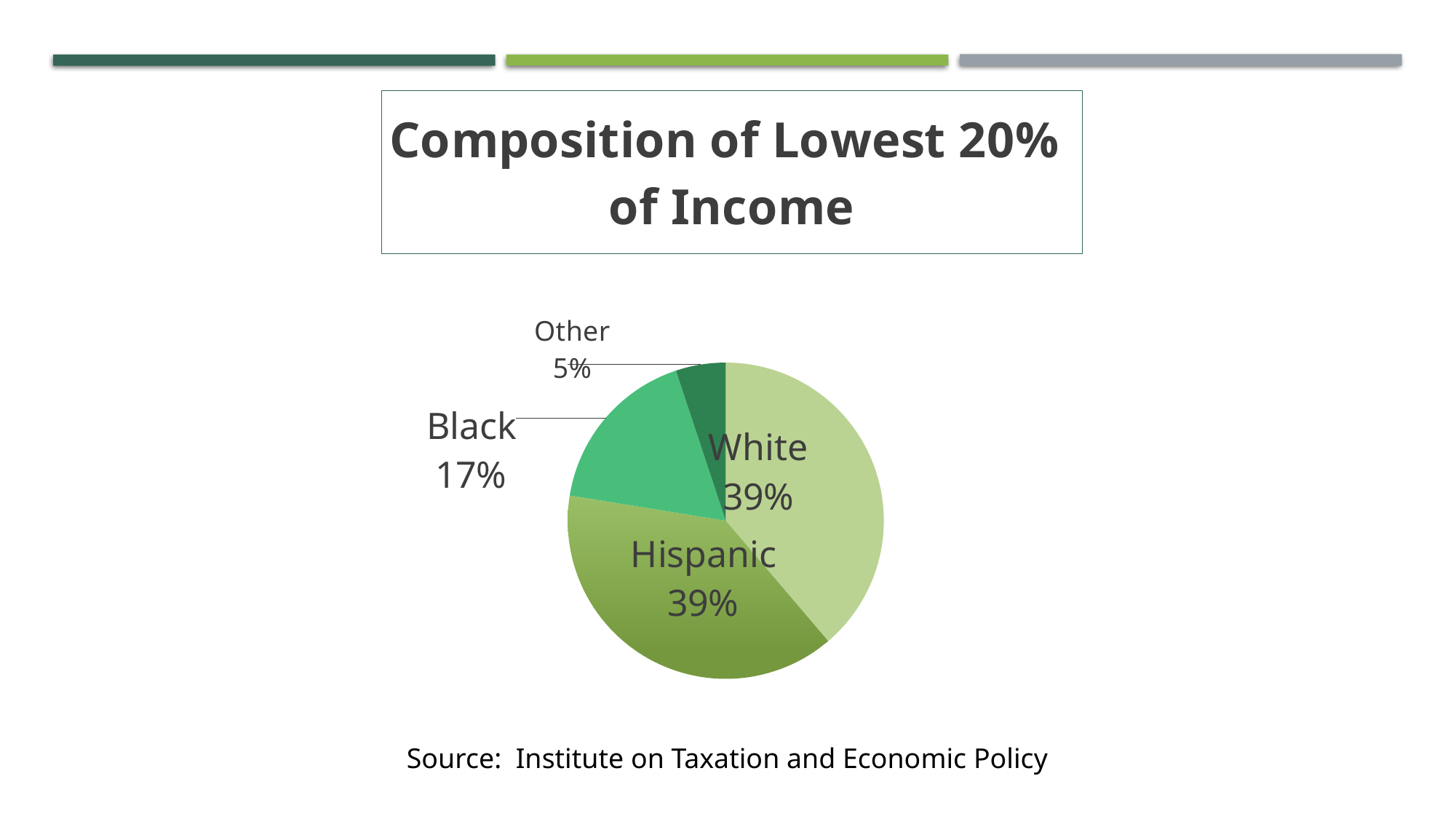
Which slice of the pie is the smallest? Other Which is larger, the Black slice or the Other slice? Black What is the difference in percentage points between the White slice and the Black slice? 22 How many slices does the pie chart have? 4 What kind of chart is shown on the slide? Pie chart What is the difference in percentage points between the Black slice and the Other slice? 12 What share of the pie does the Other slice represent? 5% What share of the pie does the Black slice represent? 17% What share of the pie does the Hispanic slice represent? 39% What is the title of the chart? Composition of Lowest 20% of Income What source is cited below the chart? Institute on Taxation and Economic Policy What share of the pie does the White slice represent? 39%